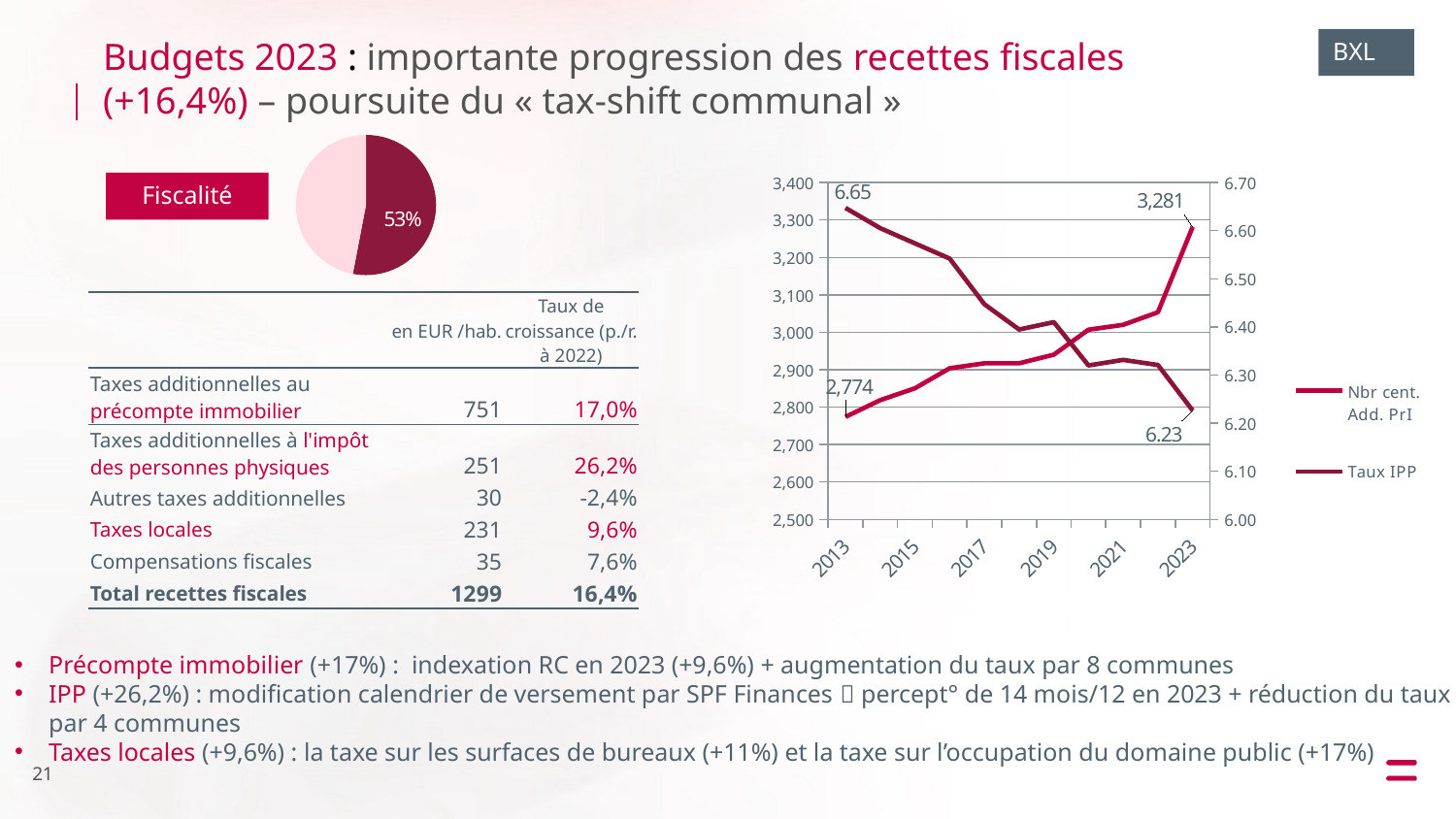
In the line chart, by how much did the Taux IPP decrease between 2013 and 2023? 0.42 What type of chart is shown on the right side of the slide? line chart How many series does the legend of the line chart list? 2 In the line chart, what is the value of Nbr cent. Add. PrI in 2013? 2,774 In the line chart, does the Taux IPP series rise or fall from 2013 to 2023? fall In the line chart, what is the value of Nbr cent. Add. PrI in 2023? 3,281 In the line chart, what is the Taux IPP value in 2013? 6.65 In the line chart, is the Nbr cent. Add. PrI value for 2021 greater or less than 2,900? greater In the line chart, by how much did Nbr cent. Add. PrI increase between 2013 and 2023? 507 What are the two legend entries of the line chart? Nbr cent. Add. PrI and Taux IPP In the line chart, what is the Taux IPP value in 2023? 6.23 In the pie chart next to the Fiscalité label, what percentage is shown on the labelled slice? 53%